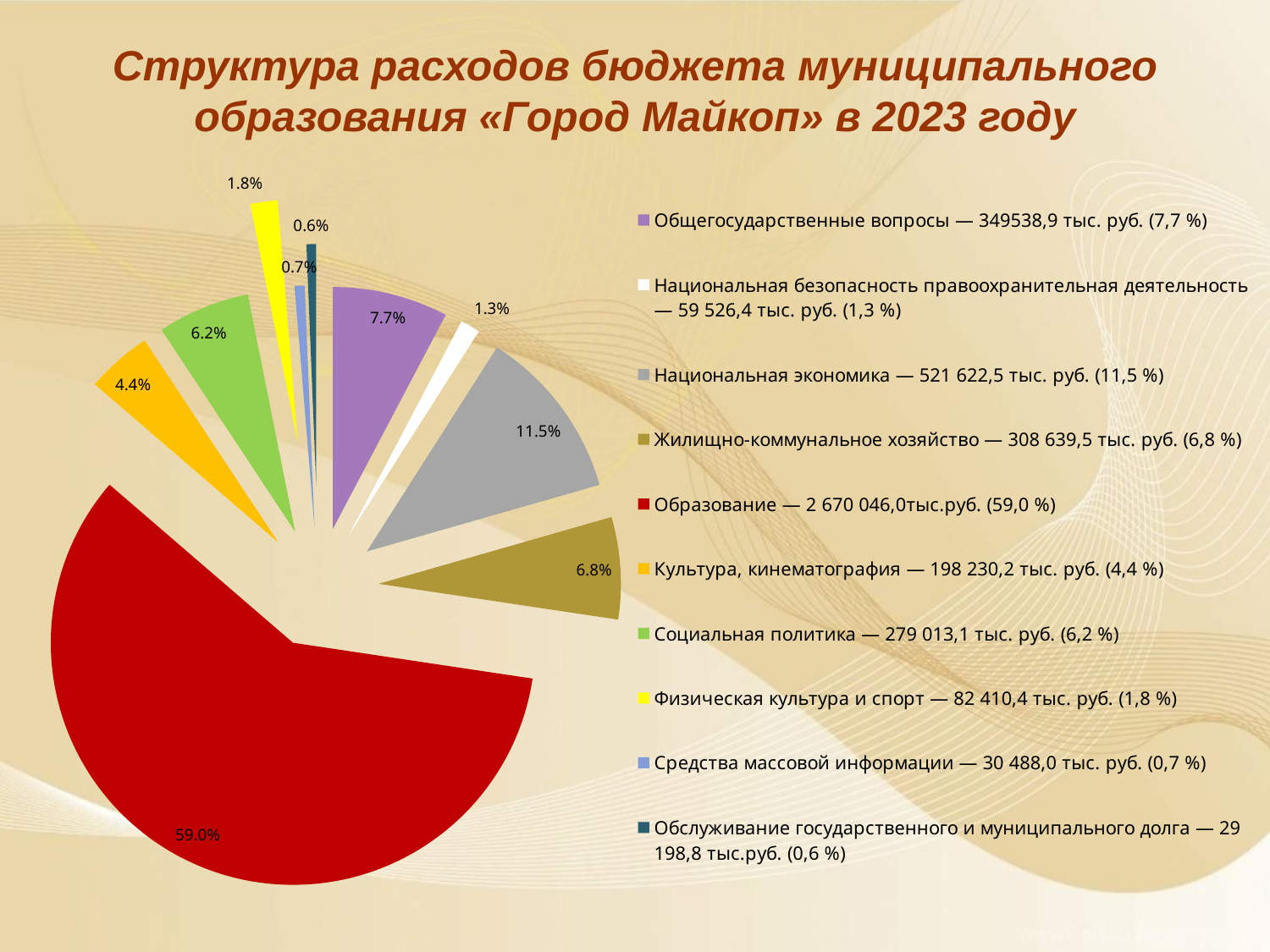
Which is larger: the slice for Социальная политика or the slice for Культура, кинематография? Социальная политика How many entries does the legend list? 10 What colour is the slice for Образование? red What share of the pie does Жилищно-коммунальное хозяйство take? 6.8% According to the legend, what is the amount for Физическая культура и спорт? 82 410,4 тыс. руб. How many slices does the pie chart have? 10 Which category has the largest slice of the pie? Образование Which category has the smallest slice of the pie? Обслуживание государственного и муниципального долга What kind of chart is shown on the slide? pie chart What share of the pie does Образование take? 59.0% What is the difference in percentage points between the Национальная экономика slice and the Общегосударственные вопросы slice? 3.8 What share of the pie does Национальная экономика take? 11.5%